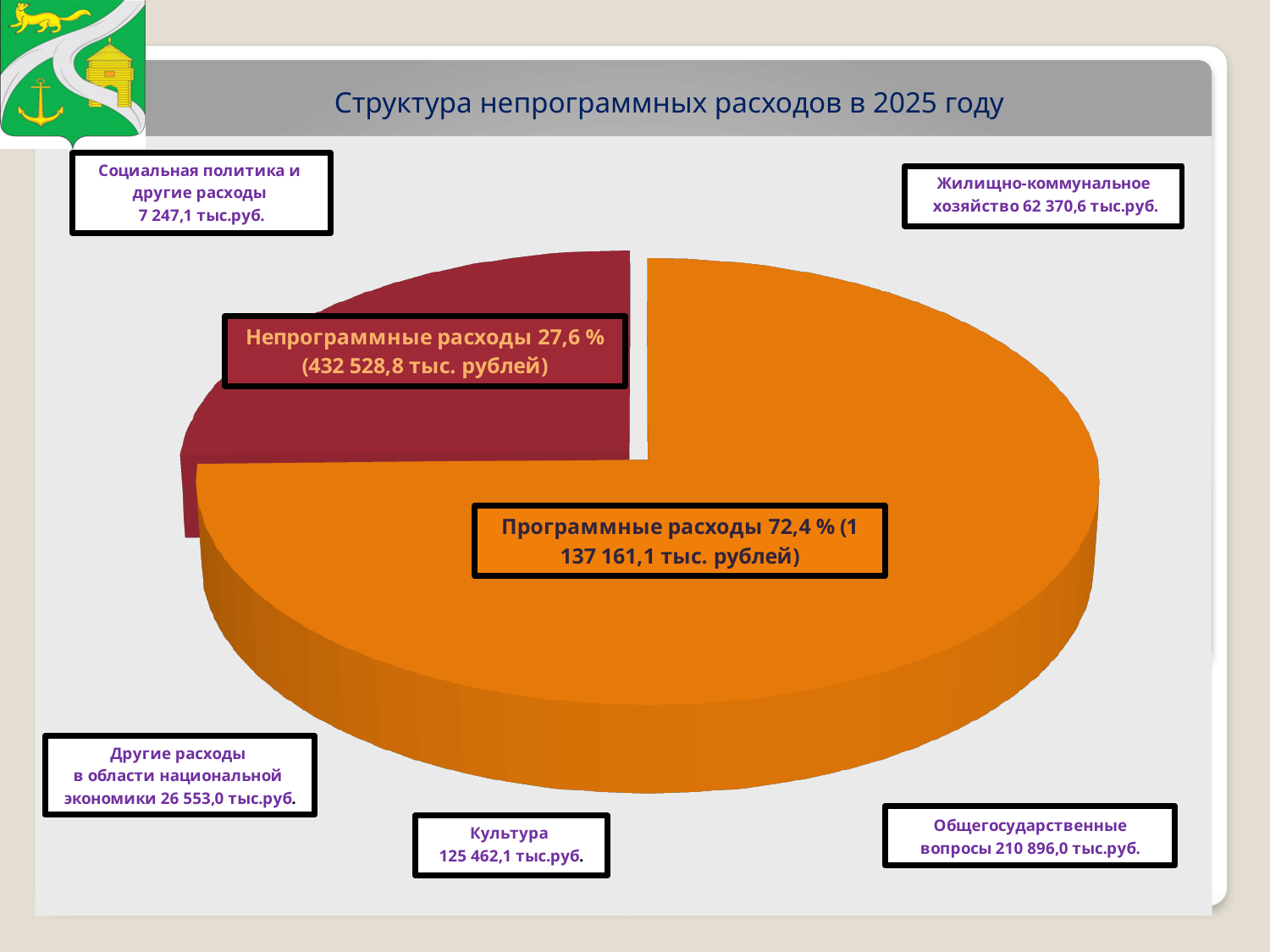
Which is larger, Программные расходы or Непрограммные расходы? Программные расходы Which slice of the pie is the largest? Программные расходы What is the value shown for Программные расходы? 1 137 161,1 тыс. рублей What is the title of the chart on the slide? Структура непрограммных расходов в 2025 году What share of the pie is Программные расходы? 72,4 % What share of the pie is Непрограммные расходы? 27,6 % How many slices does the pie chart have? 2 Which slice of the pie is the smallest? Непрограммные расходы What kind of chart is shown on the slide? Pie chart What is the difference in percentage points between the Программные расходы share and the Непрограммные расходы share? 44,8 % What is the value shown for Непрограммные расходы? 432 528,8 тыс. рублей What colour is the Непрограммные расходы slice? Dark red